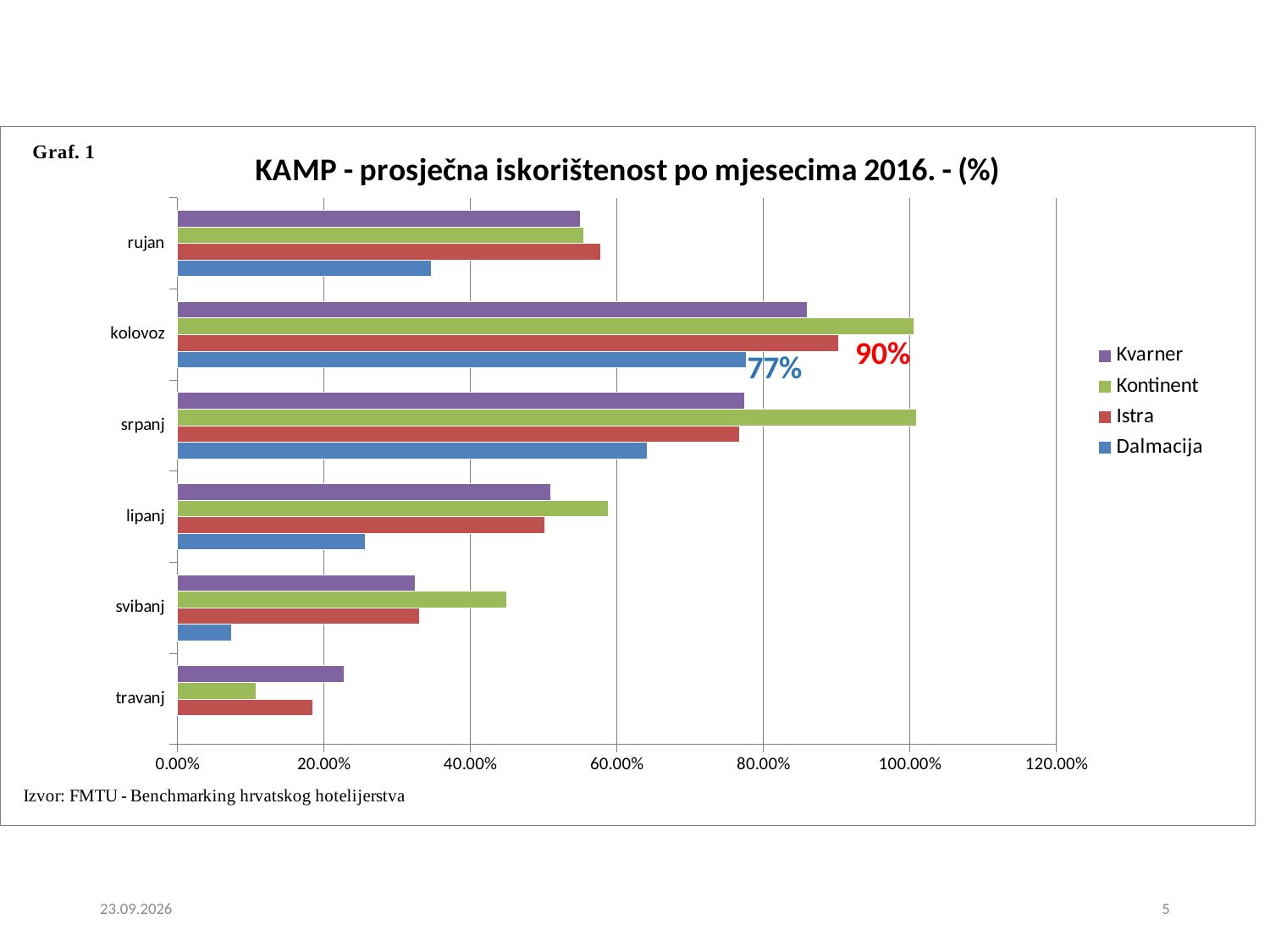
How many month categories are shown on the vertical axis? 6 How many series does the legend list? 4 Which is larger in lipanj, Kvarner or Dalmacija? Kvarner What kind of chart is shown on the slide? bar chart Which series has the lowest value in svibanj? Dalmacija Is the value for Kontinent in kolovoz greater or less than 80.00%? greater Which series has the highest value in kolovoz? Kontinent Which series is shown in blue in the legend? Dalmacija Is the value for Dalmacija in svibanj greater or less than 20.00%? less Which is larger in srpanj, Kontinent or Dalmacija? Kontinent What is the title of the chart? KAMP - prosječna iskorištenost po mjesecima 2016. - (%) Is the value for Dalmacija in rujan greater or less than 40.00%? less